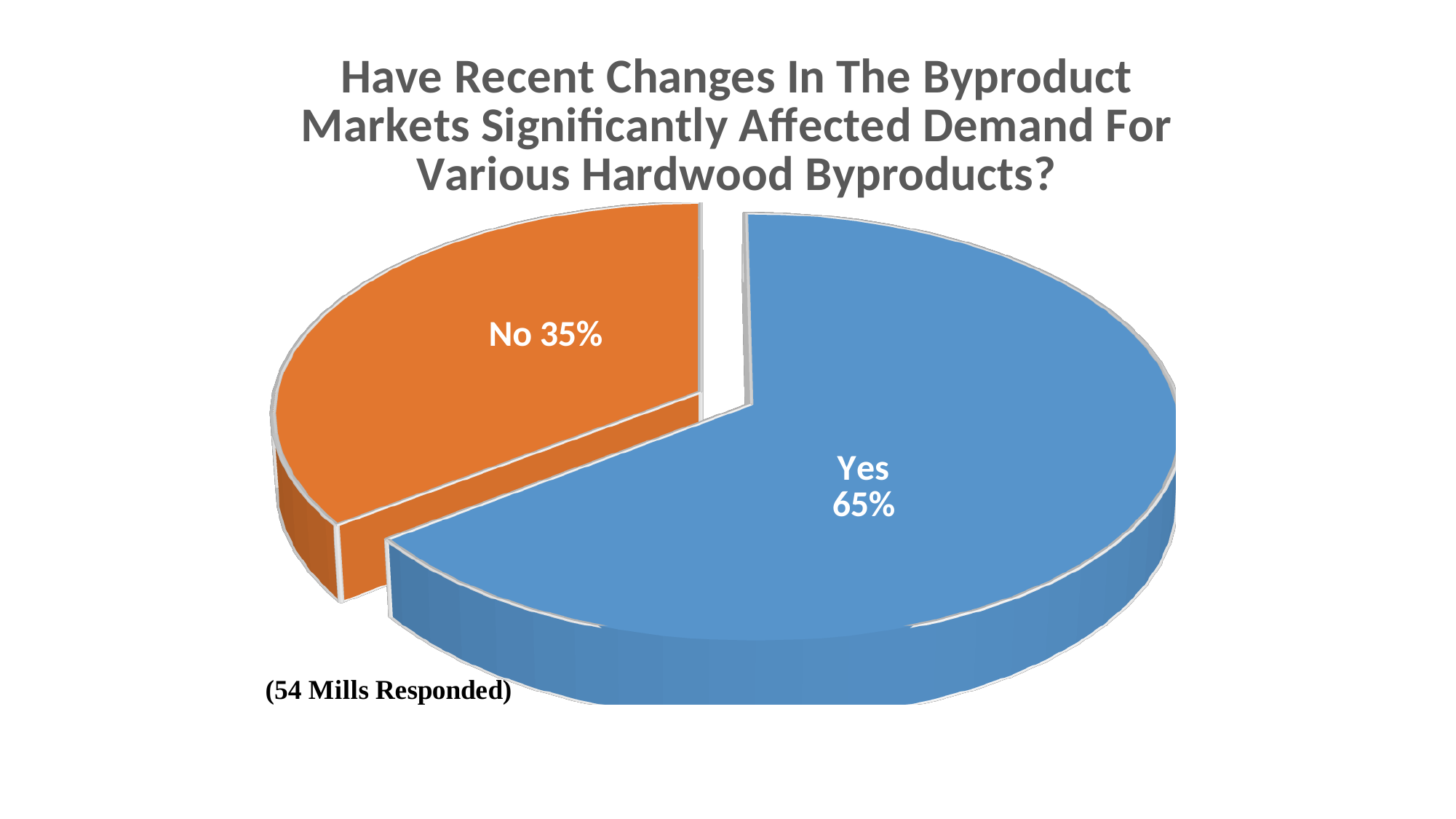
Which is larger, the "Yes" share or the "No" share? Yes Which response has the largest share of the pie? Yes What is the difference in percentage points between the "Yes" and "No" shares? 30 What percentage of respondents answered "Yes"? 65% What share of the pie does the "No" slice represent? 35% What percentage of respondents answered "No"? 35% How many mills responded to the survey, according to the note on the slide? 54 Which response has the smallest share of the pie? No What kind of chart is shown on the slide? Pie chart What colour is the "Yes" slice? Blue How many slices does the pie chart have? 2